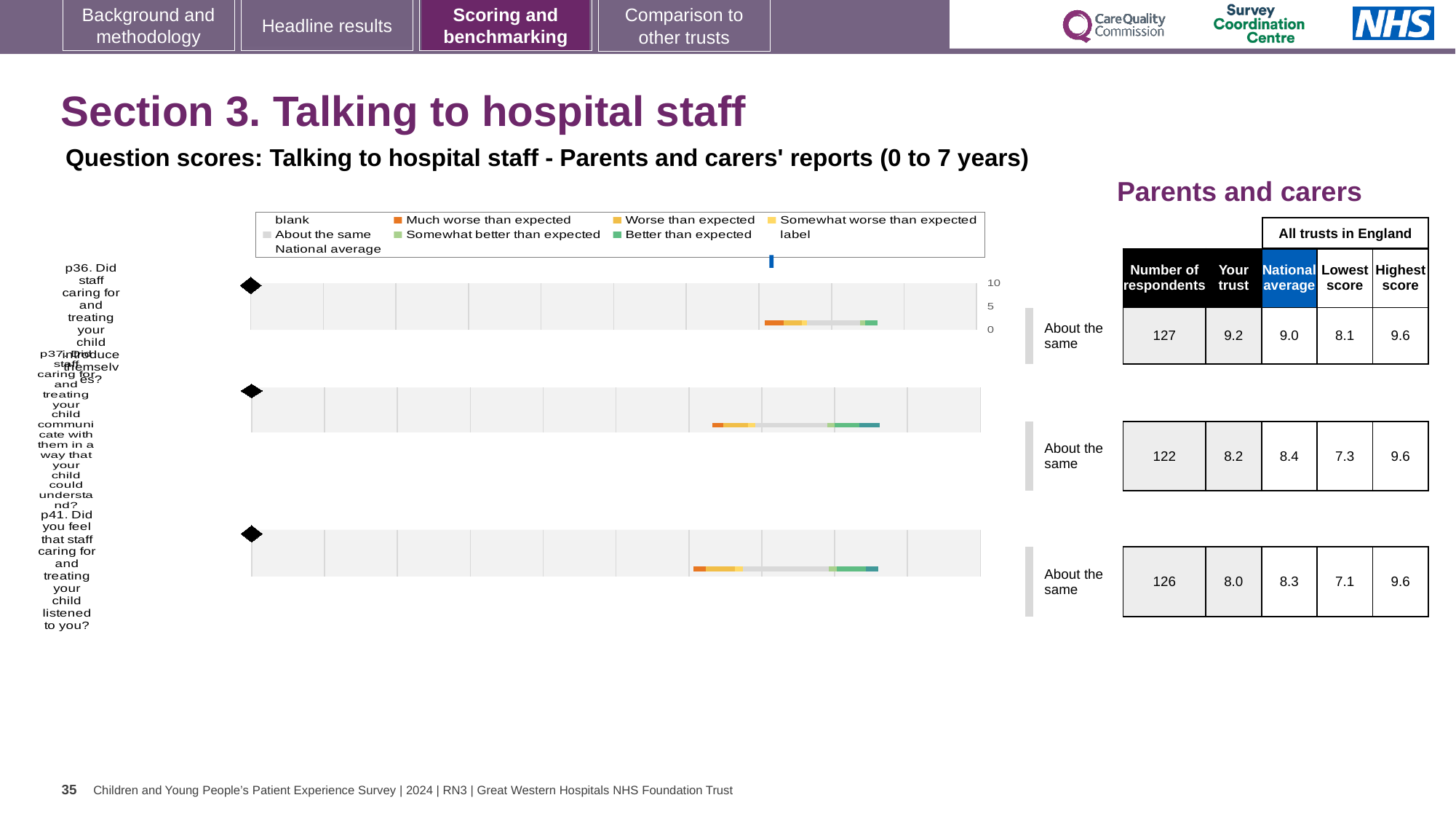
What is the highest tick value shown on the chart axis? 10 What kind of chart is used to show the benchmark results for each question on this slide? bar chart In the table beside the charts, what is the National average for p37? 8.4 Which question has the highest 'Your trust' score in the table? p36 For p41, which is larger: the 'Your trust' score or the National average? National average What benchmark category label is shown next to the chart for p36? About the same What is the difference between the 'Your trust' score and the National average for p36? 0.2 How many question rows (charts) are shown on the slide? 3 In the table beside the charts, what is the 'Your trust' score for p36? 9.2 In the chart legend, what colour represents 'Much worse than expected'? orange In the table beside the charts, how many respondents are listed for p41? 126 Which question has the lowest number of respondents in the table? p37